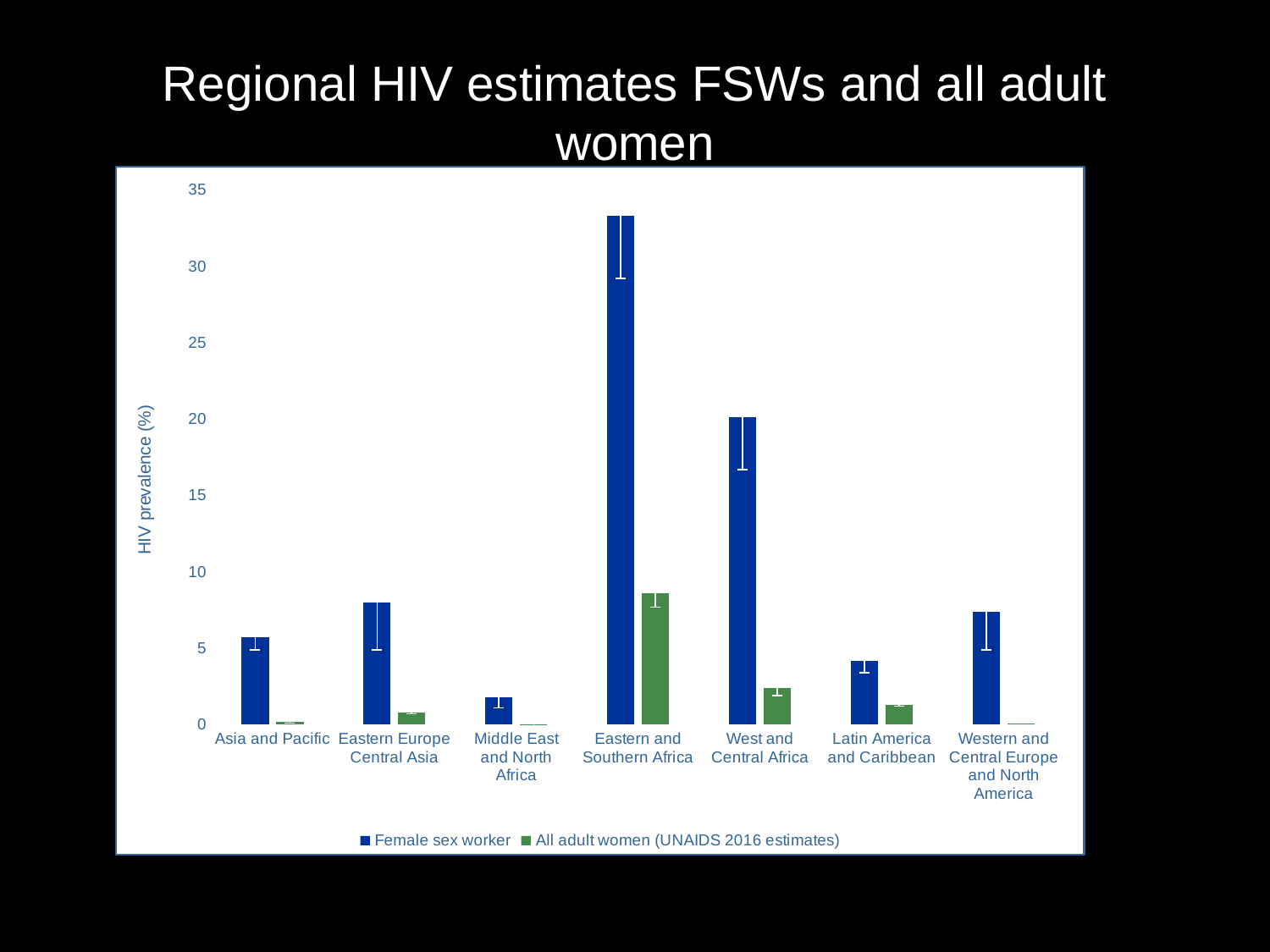
Which region has the highest HIV prevalence for female sex workers? Eastern and Southern Africa How many series does the legend list? 2 Which has the higher HIV prevalence for all adult women, Eastern and Southern Africa or West and Central Africa? Eastern and Southern Africa Which has the higher female sex worker HIV prevalence, Asia and Pacific or Eastern Europe Central Asia? Eastern Europe Central Asia What kind of chart is shown on the slide? bar chart What is the label on the y axis? HIV prevalence (%) Is the female sex worker HIV prevalence for Latin America and Caribbean greater or less than 5? less Is the female sex worker HIV prevalence for West and Central Africa greater or less than 25? less Is the female sex worker HIV prevalence for Eastern and Southern Africa greater or less than 30? greater Which region has the lowest HIV prevalence for female sex workers? Middle East and North Africa Which region has the highest HIV prevalence for all adult women? Eastern and Southern Africa How many regions are shown on the x axis? 7